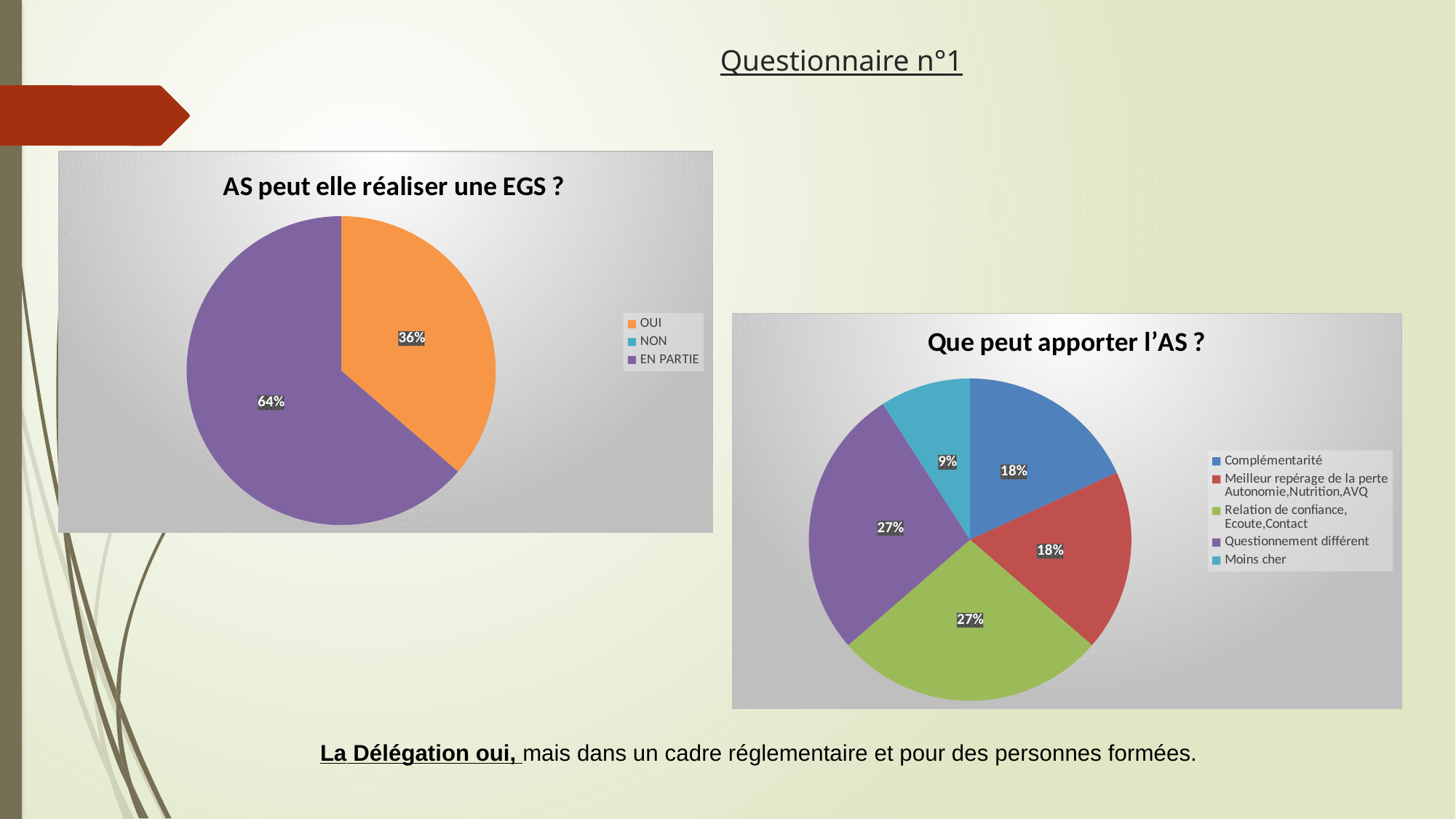
In the chart titled "Que peut apporter l'AS ?", which is larger: Relation de confiance, Ecoute,Contact or Moins cher? Relation de confiance, Ecoute,Contact In the chart titled "AS peut elle réaliser une EGS ?", what is the difference in percentage points between EN PARTIE and OUI? 28 In the chart titled "Que peut apporter l'AS ?", what share of the pie is Questionnement différent? 27% In the chart titled "Que peut apporter l'AS ?", how many slices does the pie have? 5 In the chart titled "AS peut elle réaliser une EGS ?", how many entries does the legend list? 3 In the chart titled "Que peut apporter l'AS ?", what share of the pie is Moins cher? 9% In the chart titled "AS peut elle réaliser une EGS ?", which category has the largest slice? EN PARTIE In the chart titled "AS peut elle réaliser une EGS ?", what share of the pie is labelled OUI? 36% What kind of chart is "Que peut apporter l'AS ?"? Pie chart In the chart titled "Que peut apporter l'AS ?", which category has the smallest slice? Moins cher